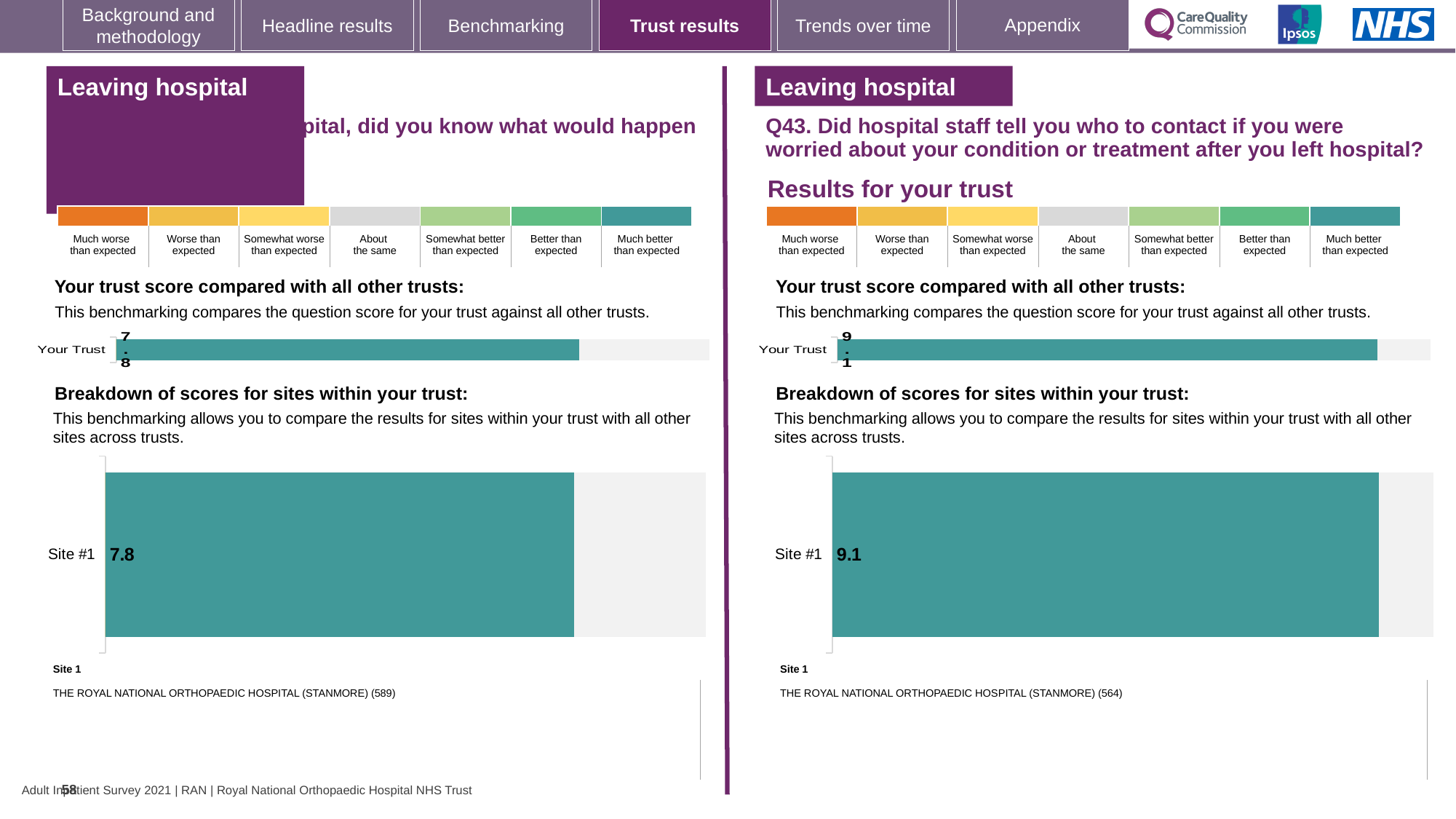
On the right-hand side of the slide (Q43), what is the 'Your Trust' score in the chart comparing the trust score with all other trusts? 9.1 In the right-hand (Q43) 'Your Trust' chart, what colour is the bar? Teal How many sites are shown in the breakdown of scores for sites within your trust on the right-hand side (Q43) of the slide? 1 Which Site #1 score is larger: the one in the left-hand breakdown chart or the one in the right-hand (Q43) breakdown chart? The right-hand (Q43) chart On the left-hand side of the slide, what is the 'Your Trust' score in the chart comparing the trust score with all other trusts? 7.8 On the left-hand side of the slide, what is the score shown for Site #1 in the breakdown of scores for sites within your trust? 7.8 What kind of chart is used to show the Site #1 score in the breakdown of scores for sites within your trust on the right-hand side (Q43)? Bar chart On the right-hand side of the slide (Q43), what is the score shown for Site #1 in the breakdown of scores for sites within your trust? 9.1 In the left-hand breakdown chart, what is the name of the site labelled Site 1? THE ROYAL NATIONAL ORTHOPAEDIC HOSPITAL (STANMORE) How many sites are shown in the breakdown of scores for sites within your trust on the left-hand side of the slide? 1 What is the difference between the Site #1 score in the right-hand (Q43) breakdown chart and the Site #1 score in the left-hand breakdown chart? 1.3